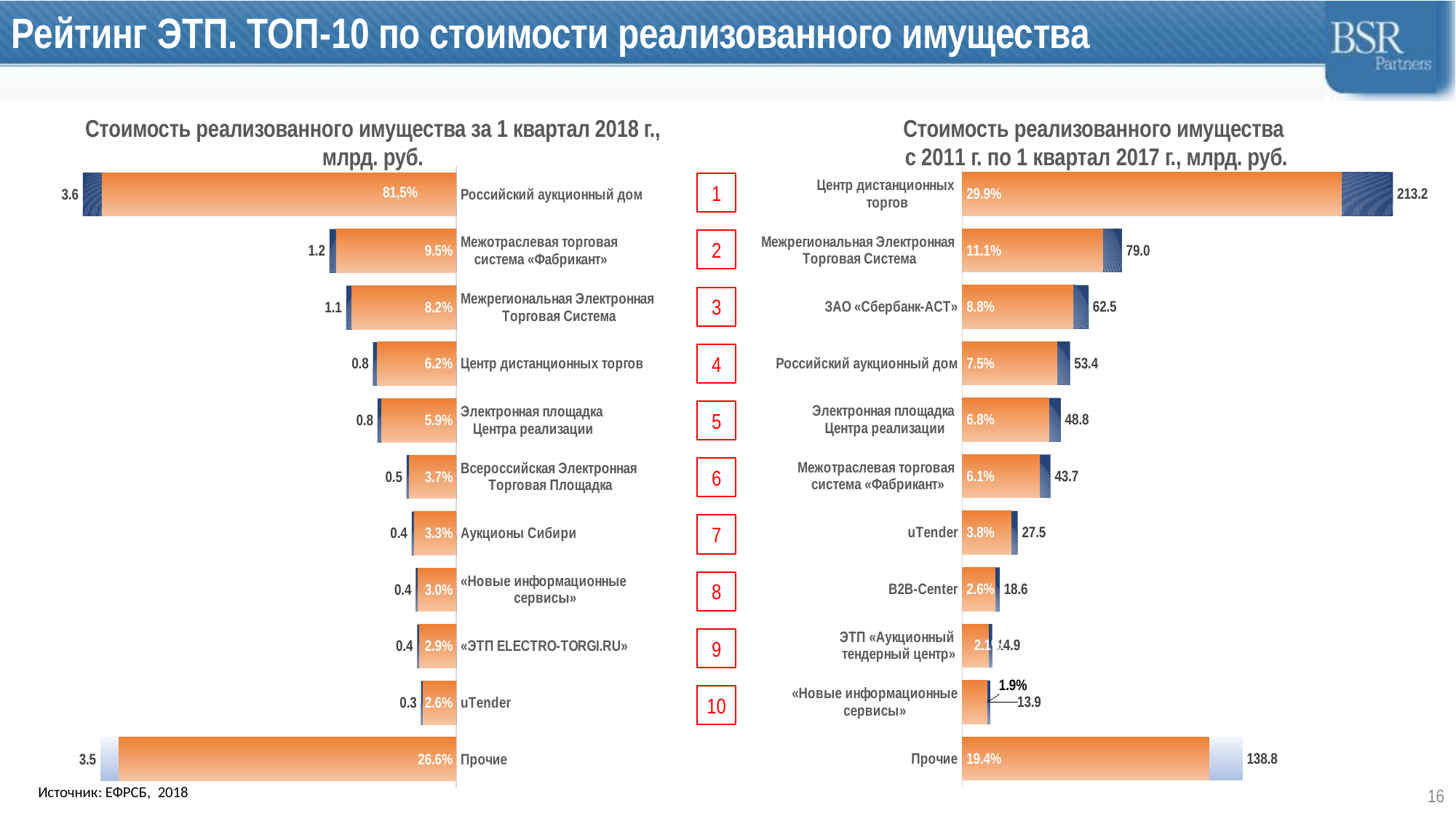
On the left chart (1 квартал 2018 г.), which of the ten ranked platforms has the highest value? Российский аукционный дом On the left chart (1 квартал 2018 г.), what is the value for Прочие? 3.5 On the left chart (1 квартал 2018 г.), what is the value for Российский аукционный дом? 3.6 On the right chart (с 2011 г. по 1 квартал 2017 г.), what percentage is shown for ЗАО «Сбербанк-АСТ»? 8.8% On the left chart (1 квартал 2018 г.), what percentage is shown for Межотраслевая торговая система «Фабрикант»? 9.5% On the right chart (с 2011 г. по 1 квартал 2017 г.), which of the ten ranked platforms has the lowest value? «Новые информационные сервисы» On the left chart (1 квартал 2018 г.), which of the ten ranked platforms has the lowest value? uTender On the right chart (с 2011 г. по 1 квартал 2017 г.), what is the difference between the values for Центр дистанционных торгов and Межрегиональная Электронная Торговая Система? 134.2 On the right chart (с 2011 г. по 1 квартал 2017 г.), what is the value for Центр дистанционных торгов? 213.2 On the right chart (с 2011 г. по 1 квартал 2017 г.), what is the value for uTender? 27.5 On the right chart (с 2011 г. по 1 квартал 2017 г.), which is larger: the value for Российский аукционный дом or for Электронная площадка Центра реализации? Российский аукционный дом What kind of chart is used on this slide? Bar chart